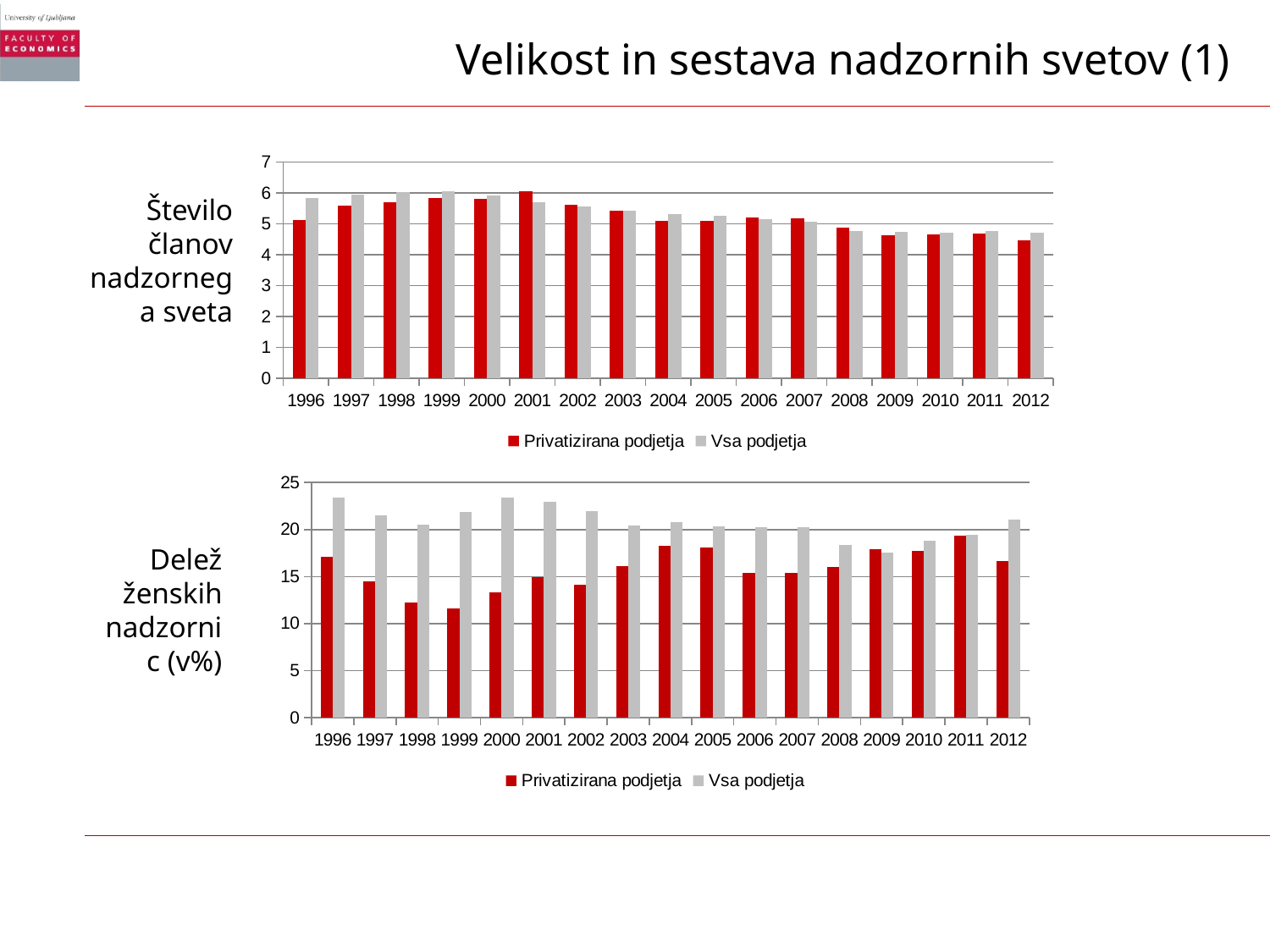
In the bottom chart (Delež ženskih nadzornic), is the value for Privatizirana podjetja in 1999 greater or less than 15? less In the bottom chart (Delež ženskih nadzornic), which year has the highest value for Privatizirana podjetja? 2011 What kind of chart is the bottom chart (Delež ženskih nadzornic)? Bar chart In the top chart (Število članov nadzornega sveta), do the values for Privatizirana podjetja generally rise or fall from 2001 to 2012? fall In the bottom chart (Delež ženskih nadzornic), which year has the lowest value for Privatizirana podjetja? 1999 In the top chart (Število članov nadzornega sveta), how many years are shown on the x axis? 17 In the top chart (Število članov nadzornega sveta), how many series does the legend list? 2 In the top chart (Število članov nadzornega sveta), which is larger in 1996: Privatizirana podjetja or Vsa podjetja? Vsa podjetja In the top chart (Število članov nadzornega sveta), is the value for Privatizirana podjetja in 2012 greater or less than 5? less In the bottom chart (Delež ženskih nadzornic), is the value for Vsa podjetja in 1996 greater or less than 20? greater In the bottom chart (Delež ženskih nadzornic), which colour represents Vsa podjetja? Grey